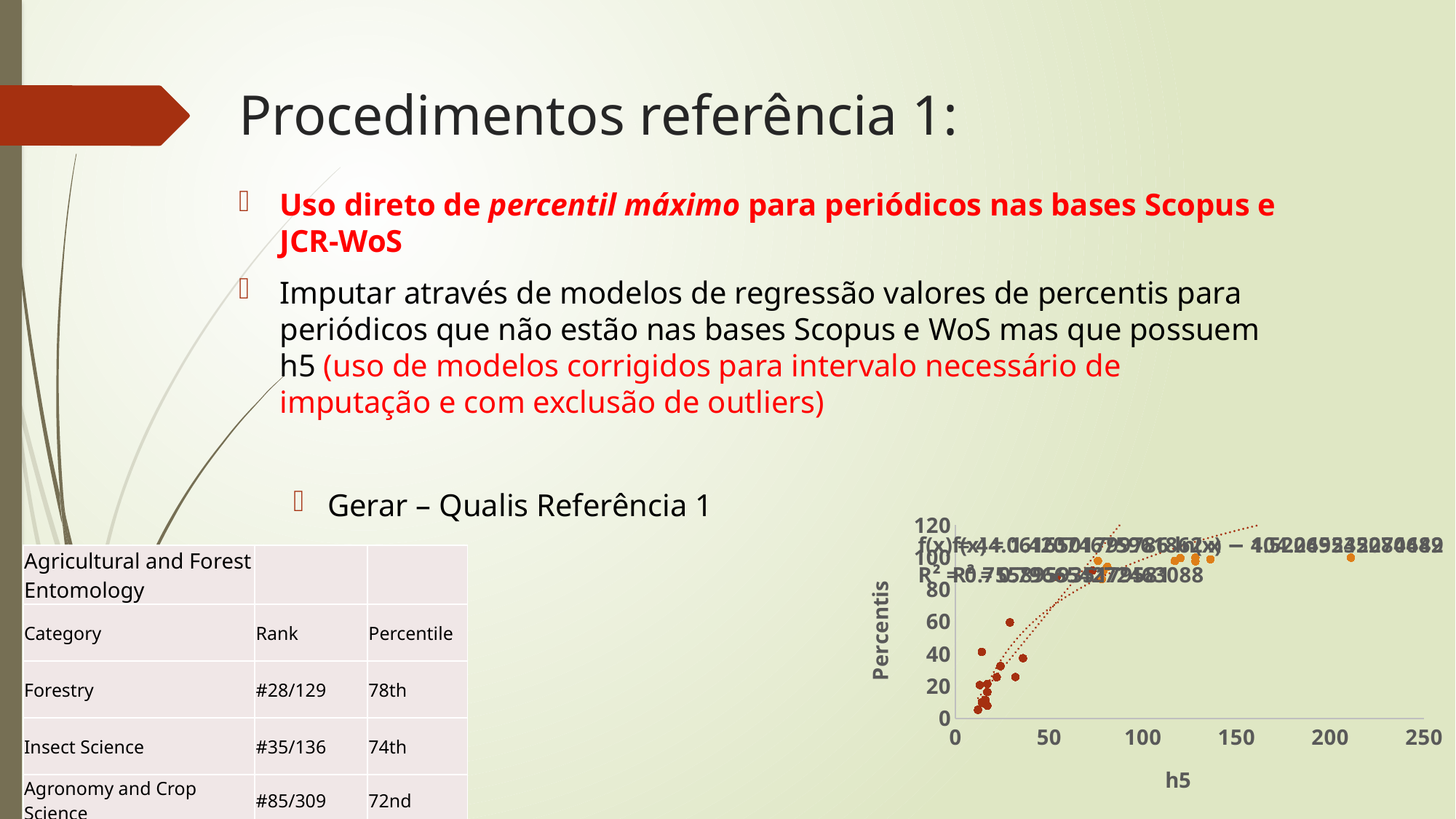
What is the title of the horizontal axis of the scatter chart? h5 Is the h5 value of the rightmost point in the scatter chart greater or less than 200? greater Do the Percentis values generally rise or fall as h5 increases along the x axis? rise What is the title of the vertical axis of the scatter chart? Percentis What kind of chart is shown on the slide? scatter chart Is the Percentis value of the rightmost point in the scatter chart greater or less than 80? greater Is the Percentis value of the lowest point in the scatter chart greater or less than 20? less